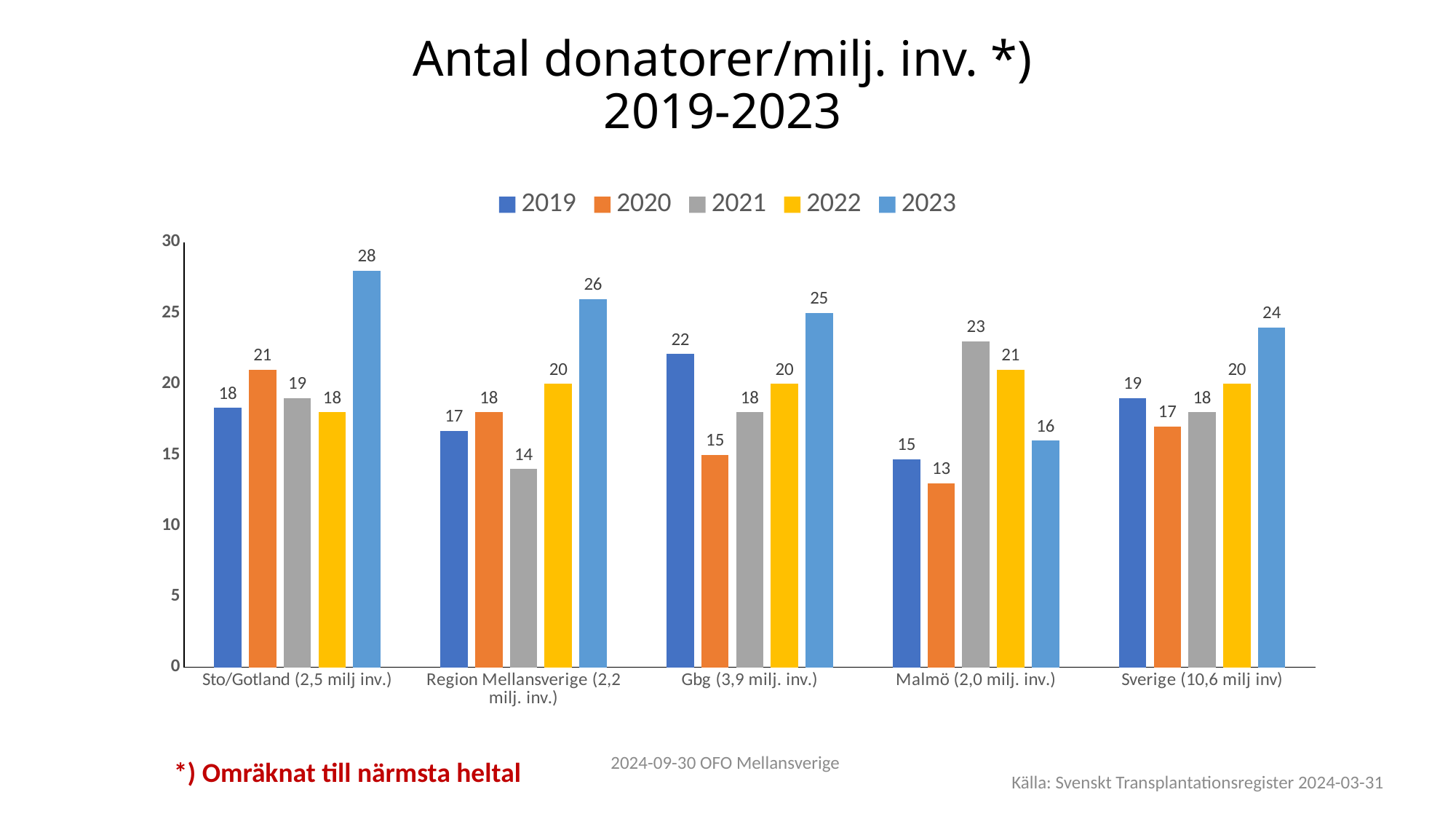
What kind of chart is shown on the slide? bar chart Which year does the orange series in the legend represent? 2020 How many categories are shown on the x axis? 5 Which category has the highest value in 2023? Sto/Gotland (2,5 milj inv.) What is the value for Sverige (10,6 milj inv) in 2020? 17 Which category has the lowest value in 2020? Malmö (2,0 milj. inv.) What is the title of the chart? Antal donatorer/milj. inv. *) 2019-2023 What is the difference between the 2023 and 2019 values for Region Mellansverige (2,2 milj. inv.)? 9 How many series does the legend list? 5 What is the value for Sto/Gotland (2,5 milj inv.) in 2023? 28 Which is larger for Gbg (3,9 milj. inv.): the 2019 value or the 2020 value? 2019 What is the value for Malmö (2,0 milj. inv.) in 2021? 23